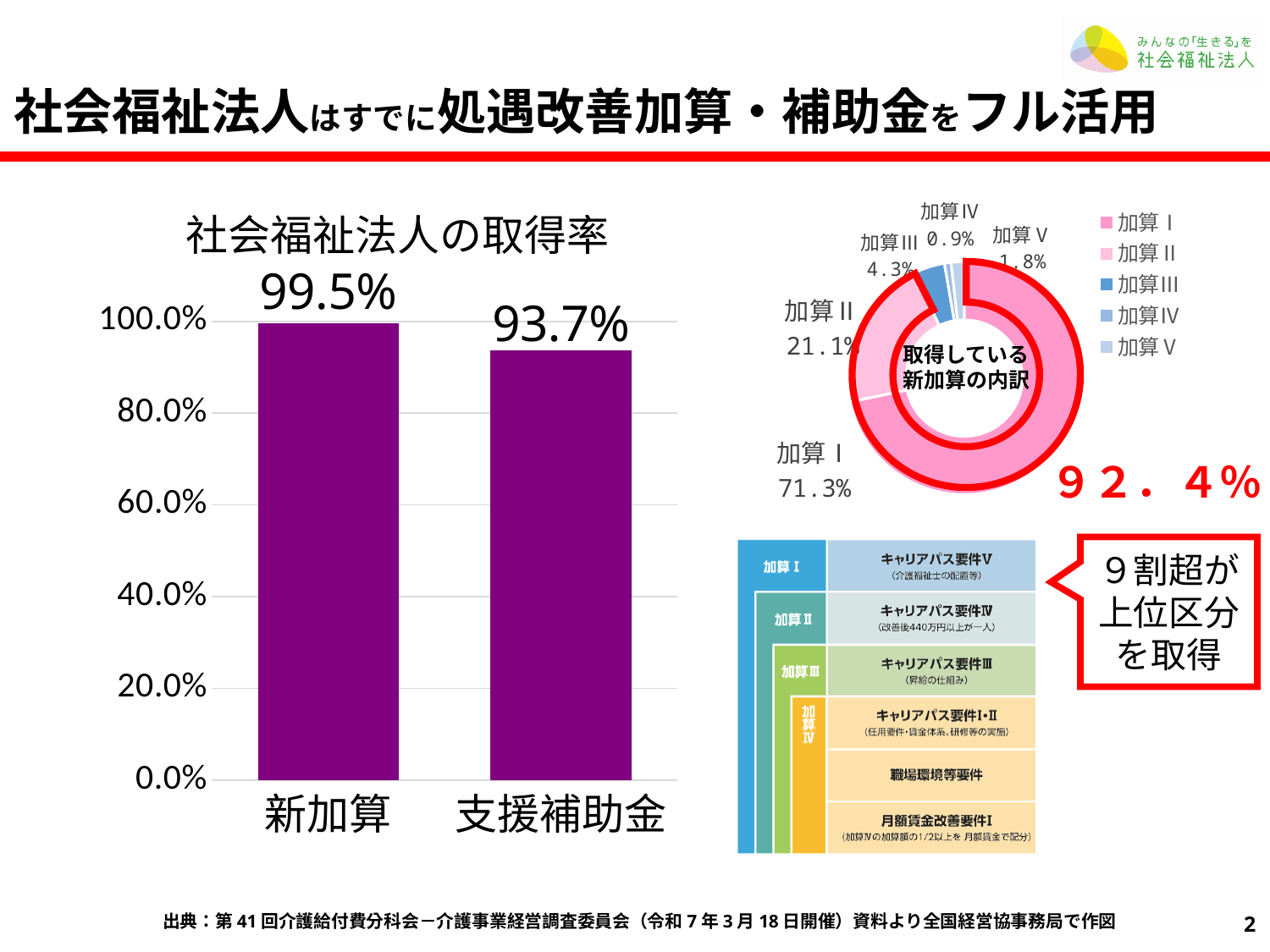
In the bar chart 社会福祉法人の取得率, what is the difference between the values for 新加算 and 支援補助金? 5.8% In the bar chart 社会福祉法人の取得率, how many bars are plotted? 2 In the bar chart 社会福祉法人の取得率, what is the value for 新加算? 99.5% In the bar chart 社会福祉法人の取得率, what is the value for 支援補助金? 93.7% In the bar chart 社会福祉法人の取得率, which category has the higher value? 新加算 In the doughnut chart 取得している新加算の内訳, which is larger, 加算Ⅲ or 加算Ⅴ? 加算Ⅲ In the doughnut chart 取得している新加算の内訳, what is the combined share of 加算Ⅰ and 加算Ⅱ? 92.4% In the doughnut chart 取得している新加算の内訳, how many entries does the legend list? 5 In the doughnut chart 取得している新加算の内訳, which category has the smallest share? 加算Ⅳ What kind of chart is the chart on the left titled 社会福祉法人の取得率? bar chart In the doughnut chart 取得している新加算の内訳, what is the share for 加算Ⅰ? 71.3% In the doughnut chart 取得している新加算の内訳, what is the share for 加算Ⅱ? 21.1%